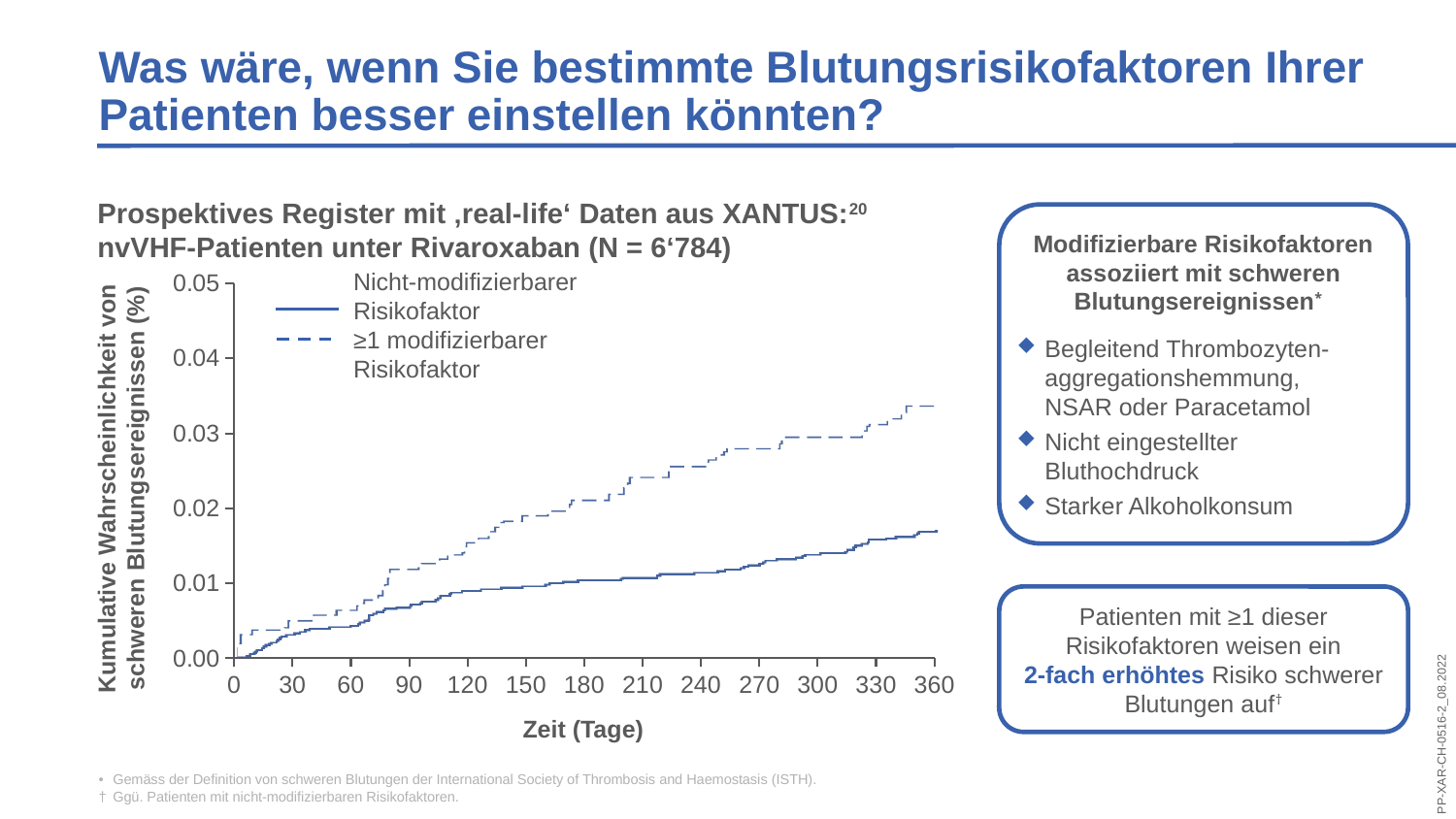
How many series does the chart legend list? 2 What is the title of the x axis of the chart? Zeit (Tage) Is the value for 'Nicht-modifizierbarer Risikofaktor' at 360 days greater or less than 0.02? less At 360 days, which series has the higher cumulative probability: 'Nicht-modifizierbarer Risikofaktor' or '≥1 modifizierbarer Risikofaktor'? ≥1 modifizierbarer Risikofaktor Do the values of the '≥1 modifizierbarer Risikofaktor' series rise or fall along the x axis? Rise Is the value for 'Nicht-modifizierbarer Risikofaktor' at 90 days greater or less than 0.01? less Is the value for '≥1 modifizierbarer Risikofaktor' at 360 days greater or less than 0.03? greater What is the last tick value shown on the x axis of the chart? 360 What is the highest value shown on the y axis of the chart? 0.05 What kind of chart is shown on the slide? Line chart Which series is shown with a dashed line in the chart? ≥1 modifizierbarer Risikofaktor